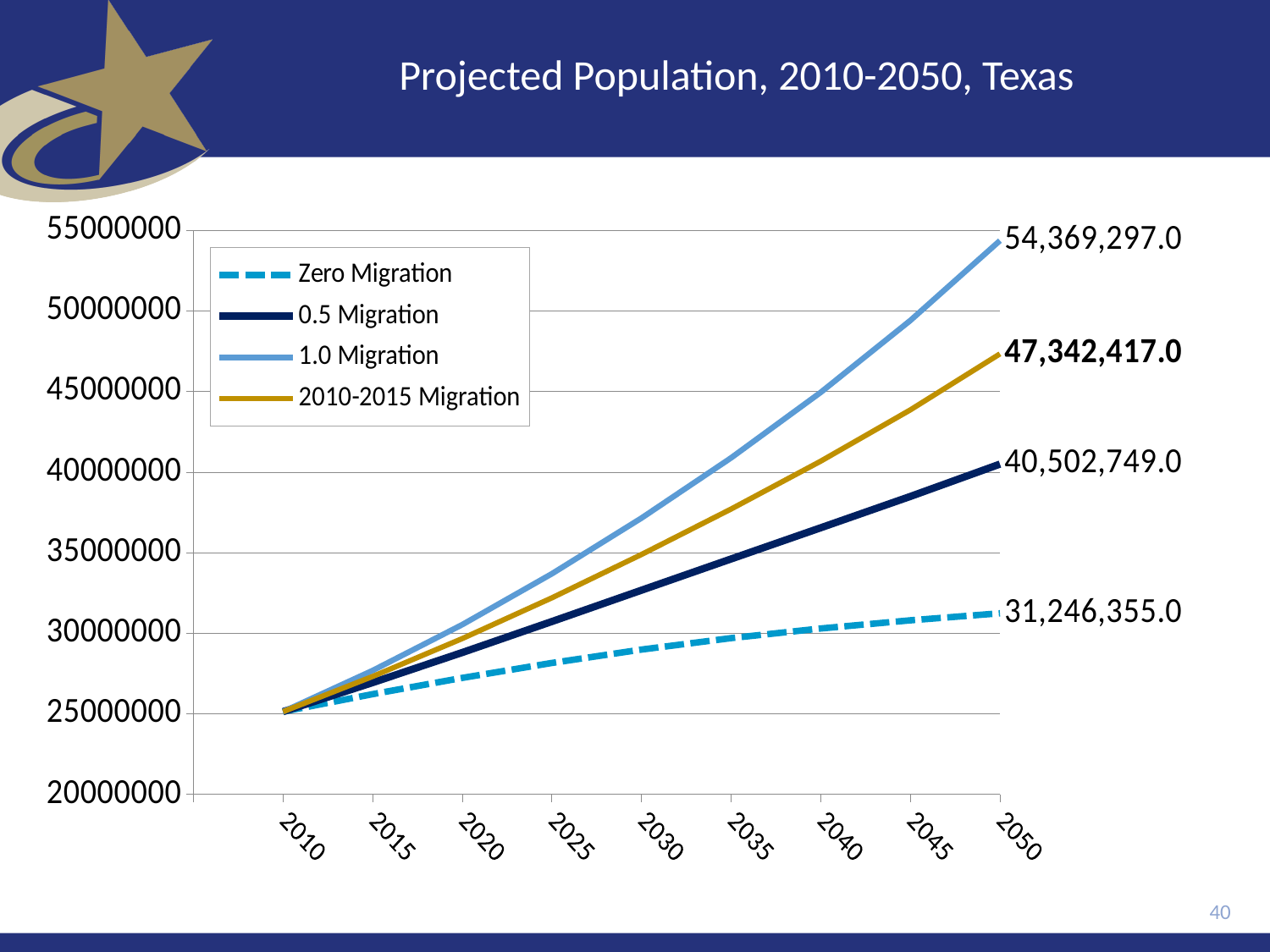
Is the Zero Migration value in 2030 greater or less than 30000000? less How many series does the legend list? 4 Which scenario has the highest projected population in 2050? 1.0 Migration Which scenario has the lowest projected population in 2050? Zero Migration What is the projected population in 2050 under the 1.0 Migration scenario? 54,369,297.0 What type of chart is shown on the slide? line chart What is the projected population in 2050 under the 2010-2015 Migration scenario? 47,342,417.0 What is the difference between the 2050 values for the 1.0 Migration and Zero Migration scenarios? 23,122,942.0 How many years are labelled along the x axis? 9 What is the projected population in 2050 under the 0.5 Migration scenario? 40,502,749.0 What is the title of the chart? Projected Population, 2010-2050, Texas What is the projected population in 2050 under the Zero Migration scenario? 31,246,355.0